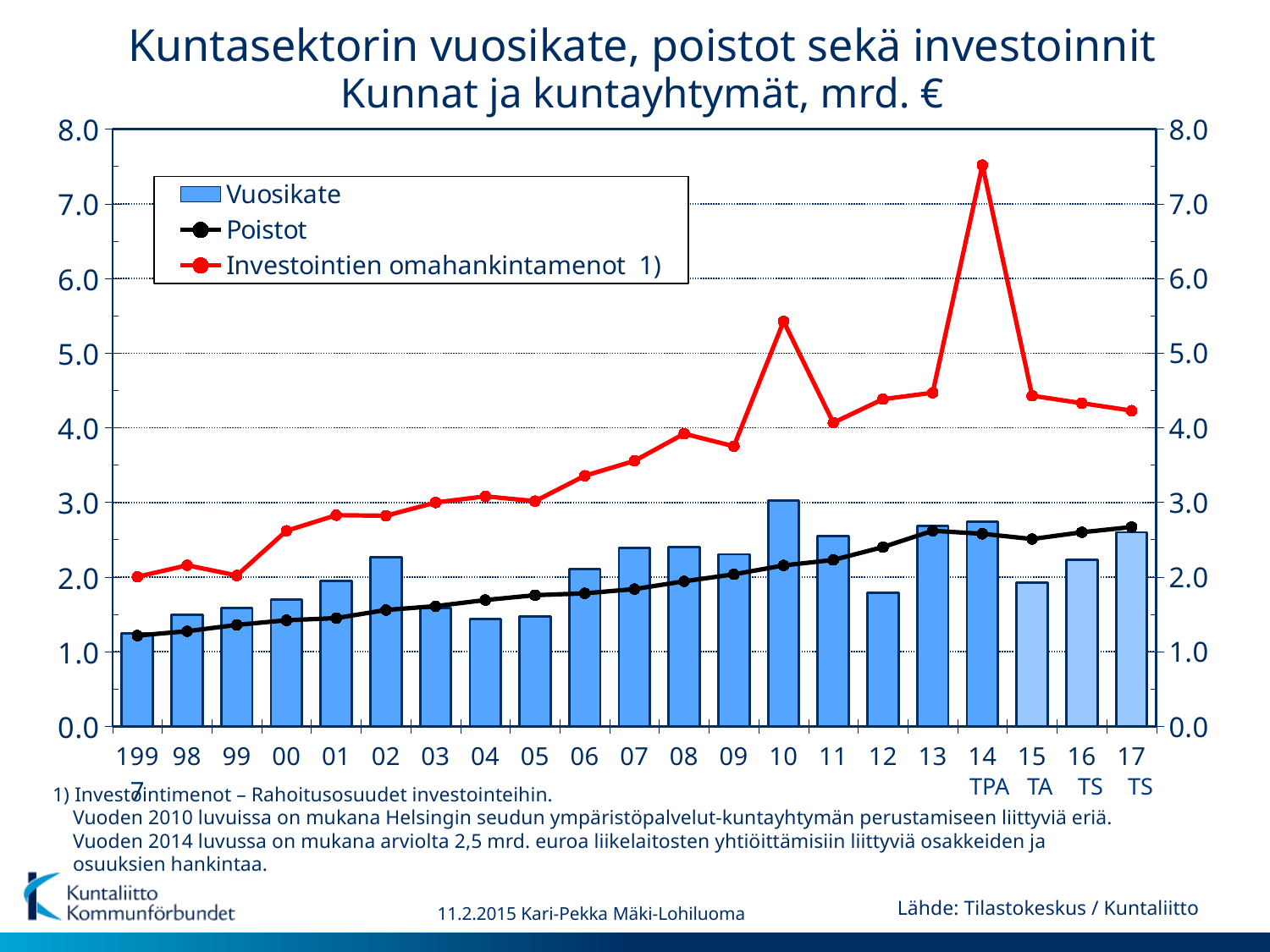
In which year does the Investointien omahankintamenot line reach its highest value? 14 How many series does the legend list? 3 In which year is the Vuosikate bar the tallest? 10 Is the Vuosikate value for 12 greater or less than 2.0? less Which is larger in 12, the Vuosikate bar or the Poistot line value? Poistot What colour is the Investointien omahankintamenot line? Red Is the Investointien omahankintamenot value for 14 greater or less than 7.0? greater In which year is the Vuosikate bar the shortest? 1997 Is the Investointien omahankintamenot value for 10 greater or less than 5.0? greater Does the Poistot line generally rise or fall from 1997 to 17? rise How many years are shown along the x axis? 21 What kind of chart is shown on the slide? A combined bar and line chart